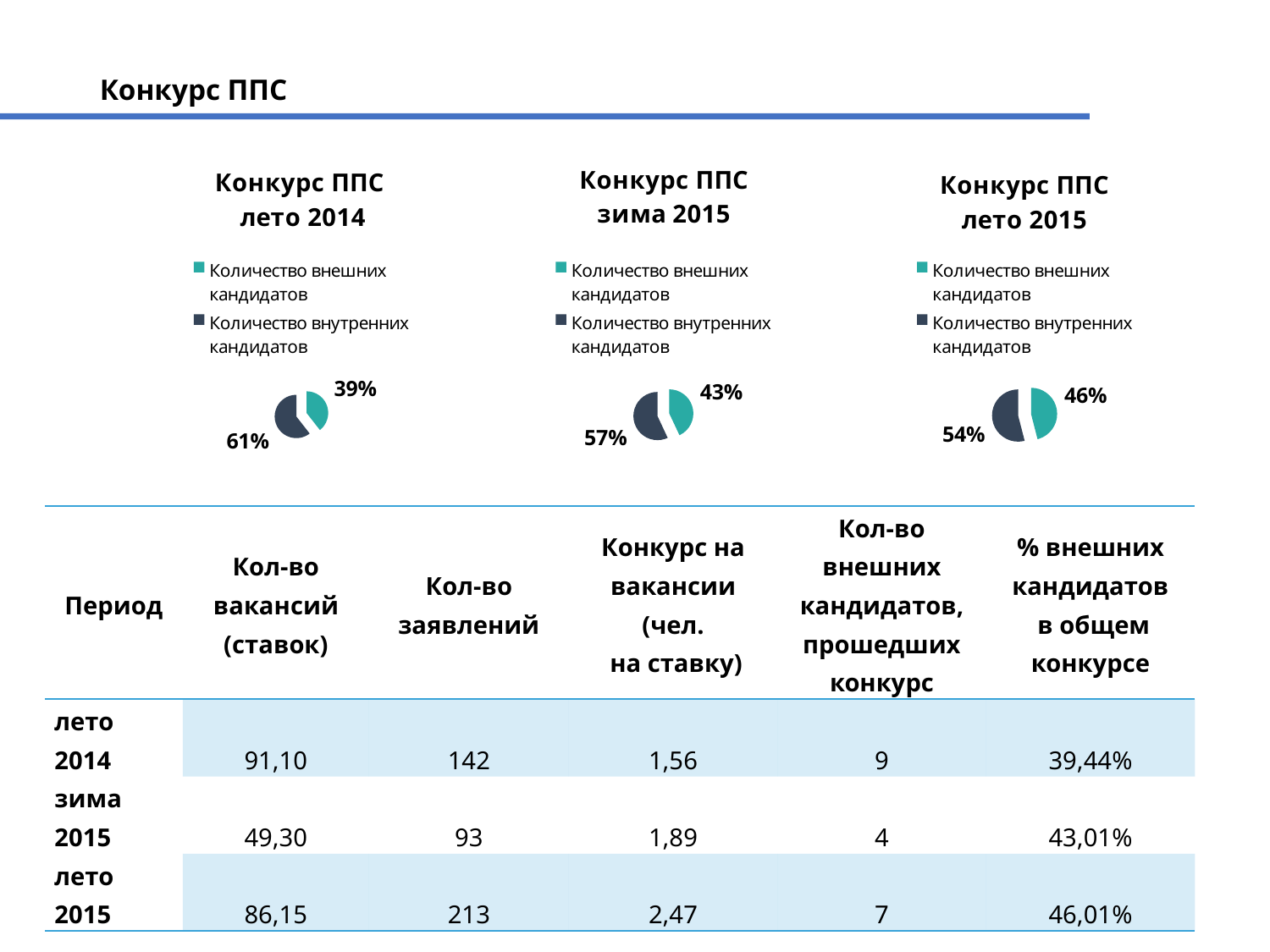
In the chart titled "Конкурс ППС лето 2014", what share of the pie is "Количество внешних кандидатов"? 39% In the chart titled "Конкурс ППС зима 2015", what share of the pie is "Количество внутренних кандидатов"? 57% How many slices does the pie chart titled "Конкурс ППС лето 2014" have? 2 In the chart titled "Конкурс ППС лето 2015", what share of the pie is "Количество внутренних кандидатов"? 54% How many entries does the legend of the chart titled "Конкурс ППС лето 2015" list? 2 In the chart titled "Конкурс ППС лето 2014", which slice is larger: "Количество внешних кандидатов" or "Количество внутренних кандидатов"? Количество внутренних кандидатов Across the three pie charts, which one has the largest "Количество внешних кандидатов" share? Конкурс ППС лето 2015 What kind of chart is "Конкурс ППС зима 2015"? Pie chart In the chart titled "Конкурс ППС лето 2015", what is the difference in percentage points between the "Количество внутренних кандидатов" slice and the "Количество внешних кандидатов" slice? 8 percentage points